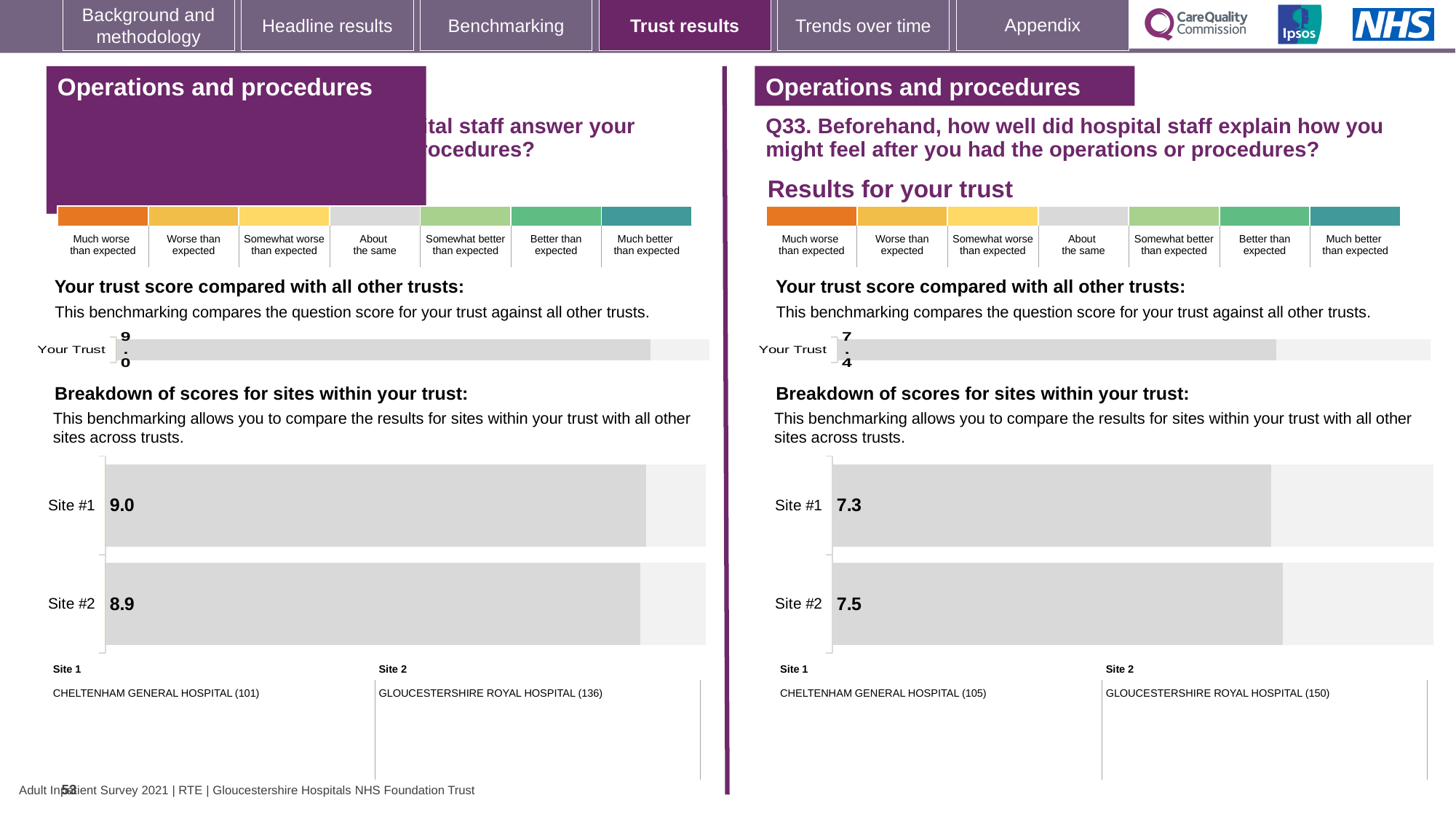
How many sites are shown in the site breakdown chart on the right-hand side (Q33)? 2 On the right-hand chart (Q33), what is the difference between the Site #2 and Site #1 scores? 0.2 What type of chart is used for the site breakdown on the right-hand side (Q33)? Bar chart On the left-hand chart, which site has the lower score? Site #2 On the left-hand chart, what is the score for Site #1? 9.0 On the left-hand chart, what is the difference between the Site #1 and Site #2 scores? 0.1 On the left-hand chart, what is the 'Your Trust' score? 9.0 On the left-hand chart, what is the score for Site #2? 8.9 On the right-hand chart (Q33), what is the score for Site #1? 7.3 On the right-hand chart (Q33), what is the 'Your Trust' score? 7.4 On the right-hand chart (Q33), what is the score for Site #2? 7.5 On the right-hand chart (Q33), which site has the higher score? Site #2